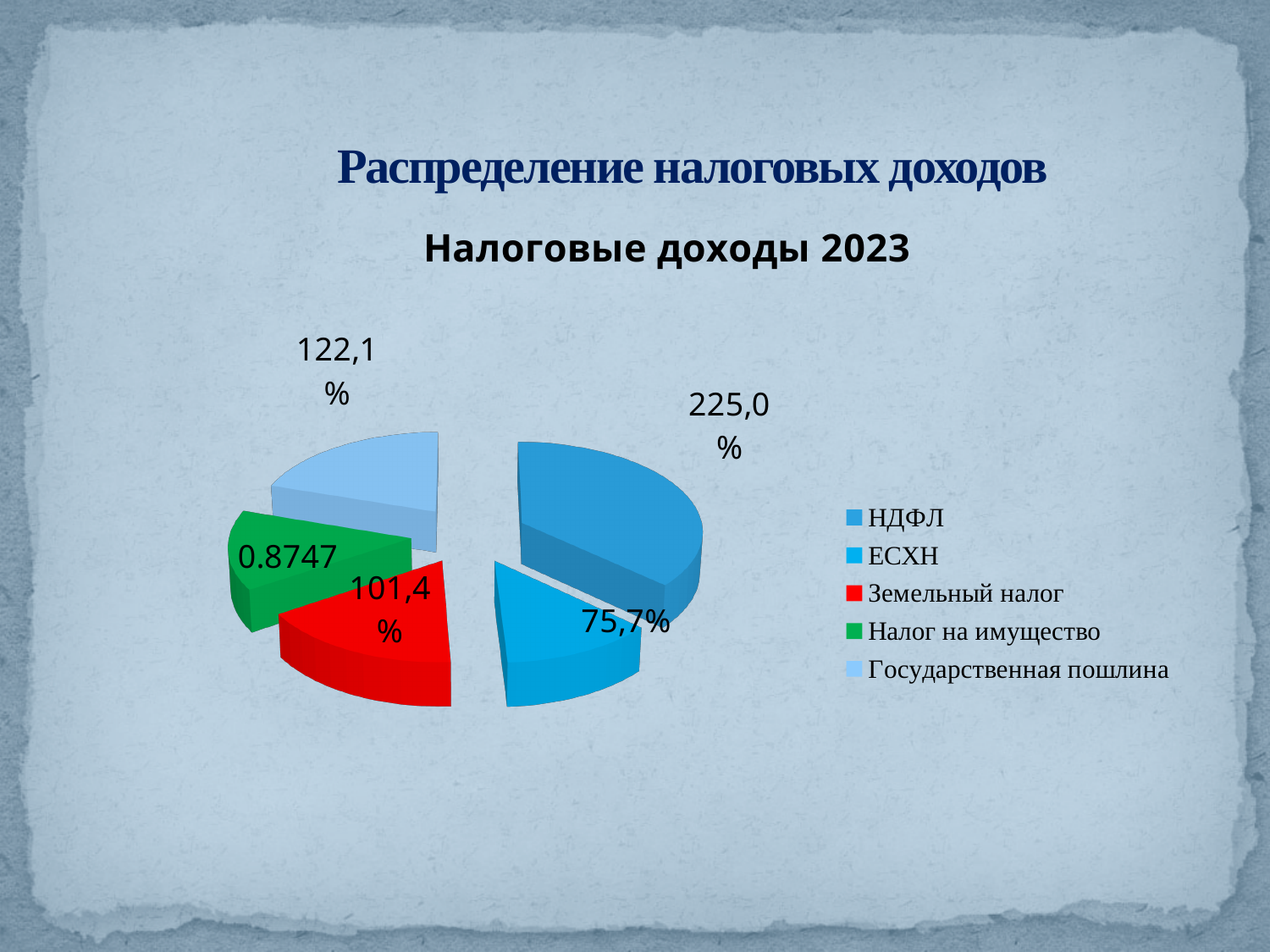
What value is shown for Налог на имущество? 0.8747 What value is shown for ЕСХН? 75,7% What value is shown for Государственная пошлина? 122,1% What is the difference between the values for Земельный налог and ЕСХН? 25,7% What kind of chart is shown on the slide? pie chart What is the title of the chart? Налоговые доходы 2023 Which is larger, the value for Государственная пошлина or the value for Земельный налог? Государственная пошлина How many slices does the pie chart have? 5 What value is shown for Земельный налог? 101,4% What value is shown for НДФЛ? 225,0% Which category has the smallest slice of the pie? ЕСХН Which category has the largest slice of the pie? НДФЛ